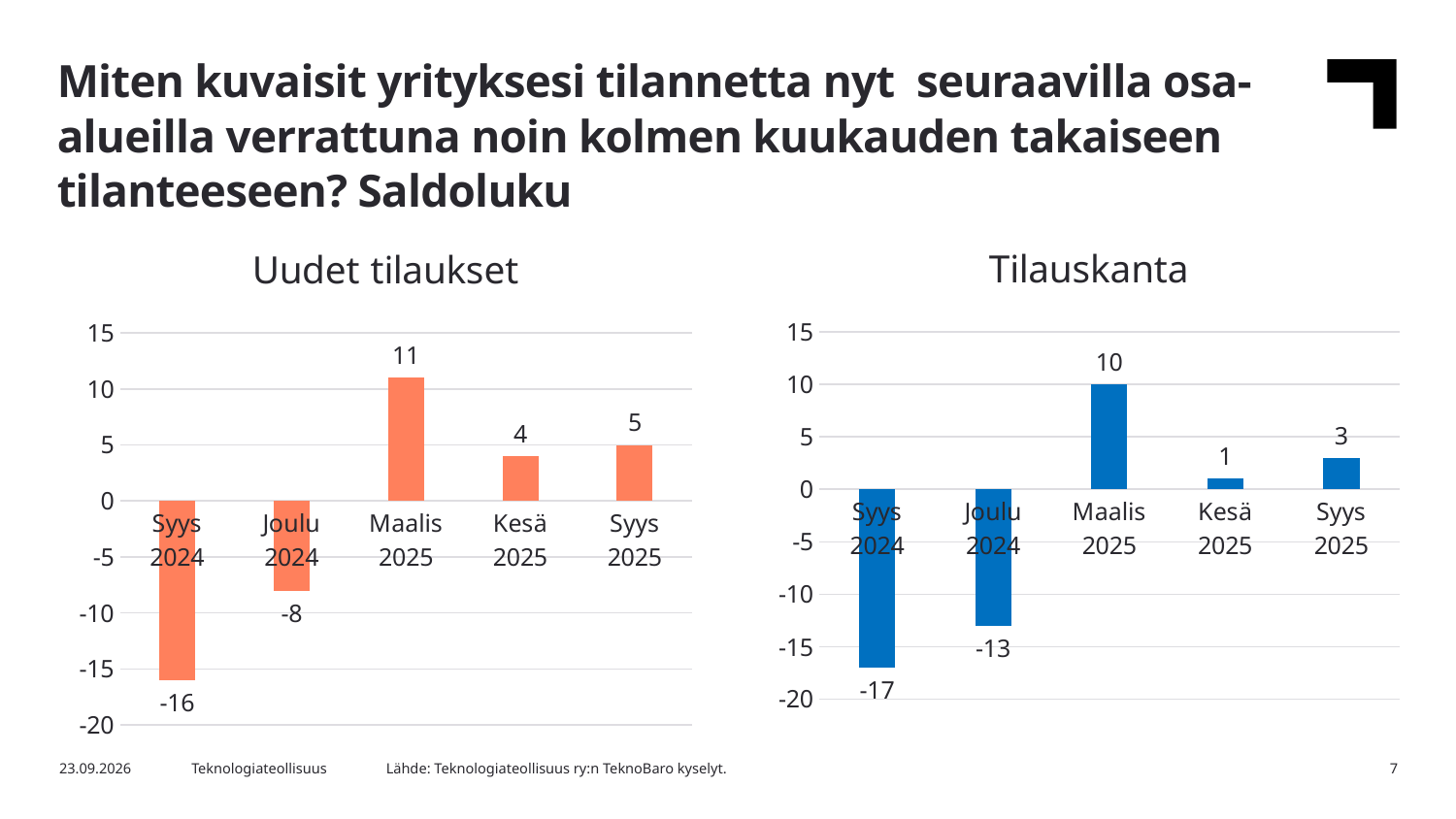
In the 'Uudet tilaukset' chart, which period has the lowest value? Syys 2024 In the 'Tilauskanta' chart, what is the difference between the values for Syys 2024 and Joulu 2024? 4 In the 'Tilauskanta' chart, which period has the highest value? Maalis 2025 In the 'Uudet tilaukset' chart, what is the difference between the values for Maalis 2025 and Syys 2025? 6 In the 'Tilauskanta' chart, do the values rise or fall from Syys 2024 to Maalis 2025? rise How many periods are shown on the x axis of the 'Tilauskanta' chart? 5 What kind of chart is the 'Uudet tilaukset' chart? bar chart In the 'Tilauskanta' chart, which is larger, the value for Kesä 2025 or Syys 2025? Syys 2025 In the 'Tilauskanta' chart, what is the value for Joulu 2024? -13 In the 'Uudet tilaukset' chart, is the value for Syys 2024 greater or less than -15? less In the 'Uudet tilaukset' chart, what is the value for Maalis 2025? 11 What is the title of the chart on the right side of the slide? Tilauskanta